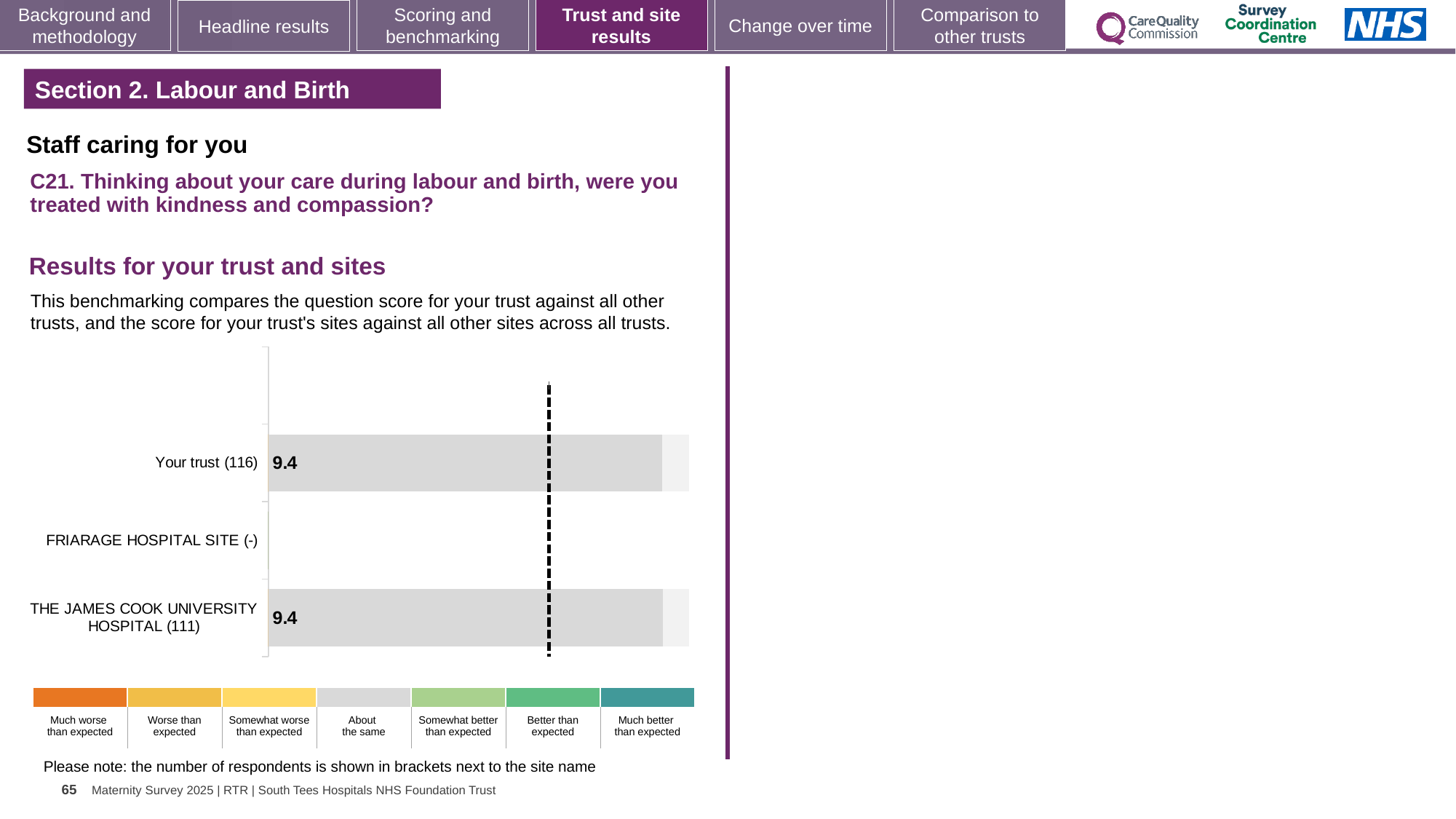
What type of chart is used to show the results for your trust and sites? Bar chart Which site has no bar or score displayed on the chart? FRIARAGE HOSPITAL SITE (-) What is the difference between the score for Your trust (116) and the score for THE JAMES COOK UNIVERSITY HOSPITAL (111)? 0 How many respondents are shown in brackets for Your trust? 116 Is the score for Your trust (116) greater or less than 9? greater What is the score shown for THE JAMES COOK UNIVERSITY HOSPITAL (111)? 9.4 Which survey question does the chart relate to? C21. Thinking about your care during labour and birth, were you treated with kindness and compassion? How many respondents are shown in brackets for THE JAMES COOK UNIVERSITY HOSPITAL? 111 How many benchmark categories are shown in the colour key below the chart? 7 How many categories (rows) are listed on the chart's vertical axis? 3 Which benchmark category in the colour key is shown in grey? About the same What is the score shown for Your trust (116)? 9.4